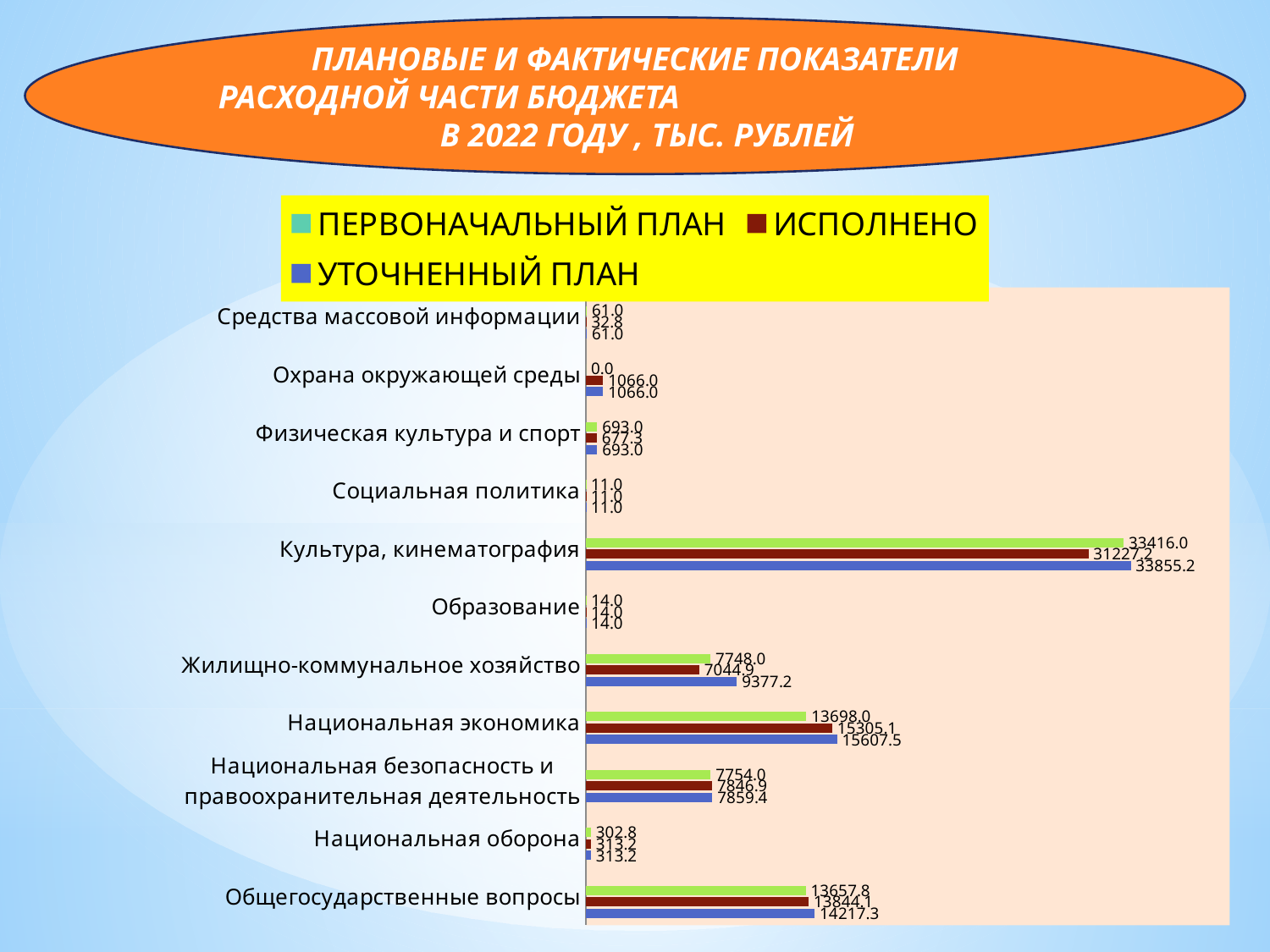
What is the УТОЧНЕННЫЙ ПЛАН value for Национальная экономика? 15607.5 Which category has the lowest ИСПОЛНЕНО value? Социальная политика What is the ИСПОЛНЕНО value for Средства массовой информации? 32.8 Which is larger for Жилищно-коммунальное хозяйство: the ПЕРВОНАЧАЛЬНЫЙ ПЛАН value or the УТОЧНЕННЫЙ ПЛАН value? УТОЧНЕННЫЙ ПЛАН Which colour represents the ИСПОЛНЕНО series in the legend? dark red What is the ПЕРВОНАЧАЛЬНЫЙ ПЛАН value for Охрана окружающей среды? 0.0 How many categories are shown on the chart? 11 How many series does the legend list? 3 What is the difference between the УТОЧНЕННЫЙ ПЛАН and ИСПОЛНЕНО values for Культура, кинематография? 2628.0 What type of chart is shown on the slide? bar chart Which category has the highest УТОЧНЕННЫЙ ПЛАН value? Культура, кинематография What is the ИСПОЛНЕНО value for Культура, кинематография? 31227.2